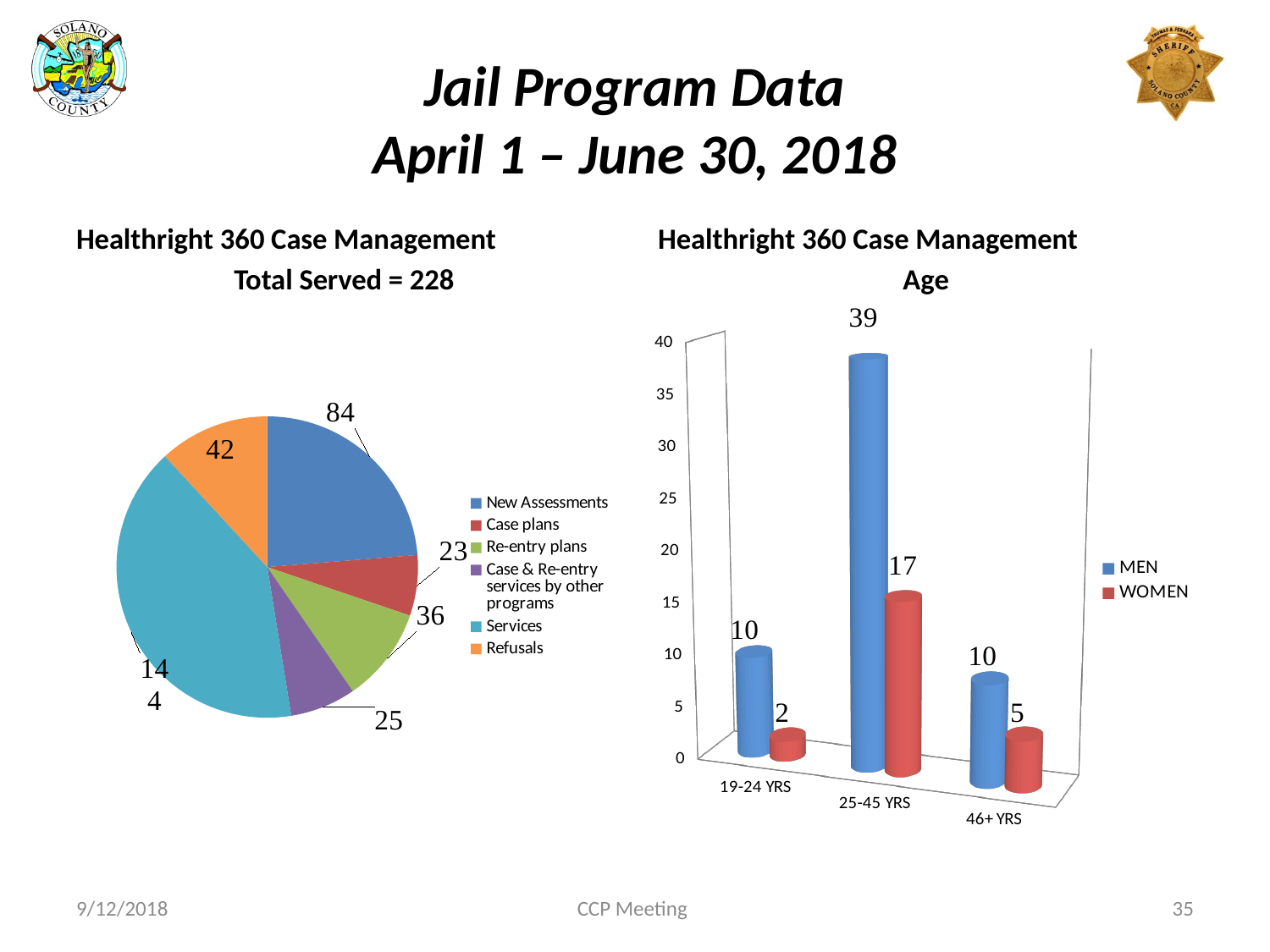
In the Healthright 360 Case Management Age bar chart, what is the difference between MEN and WOMEN in the 25-45 YRS group? 22 In the Healthright 360 Case Management Age bar chart, what is the value for WOMEN in the 19-24 YRS group? 2 In the Healthright 360 Case Management Total Served = 228 pie chart, what is the value for New Assessments? 84 How many categories does the legend of the Healthright 360 Case Management Total Served = 228 pie chart list? 6 In the Healthright 360 Case Management Total Served = 228 pie chart, what is the value for Refusals? 42 In the Healthright 360 Case Management Age bar chart, which age group has the highest value for WOMEN? 25-45 YRS What kind of chart is the Healthright 360 Case Management Age chart? bar chart How many age groups are shown in the Healthright 360 Case Management Age chart? 3 In the Healthright 360 Case Management Age bar chart, what is the value for WOMEN in the 46+ YRS group? 5 How many series does the legend of the Healthright 360 Case Management Age bar chart list? 2 In the Healthright 360 Case Management Age bar chart, what is the value for MEN in the 25-45 YRS group? 39 In the Healthright 360 Case Management Total Served = 228 pie chart, which is larger, Re-entry plans or Case plans? Re-entry plans